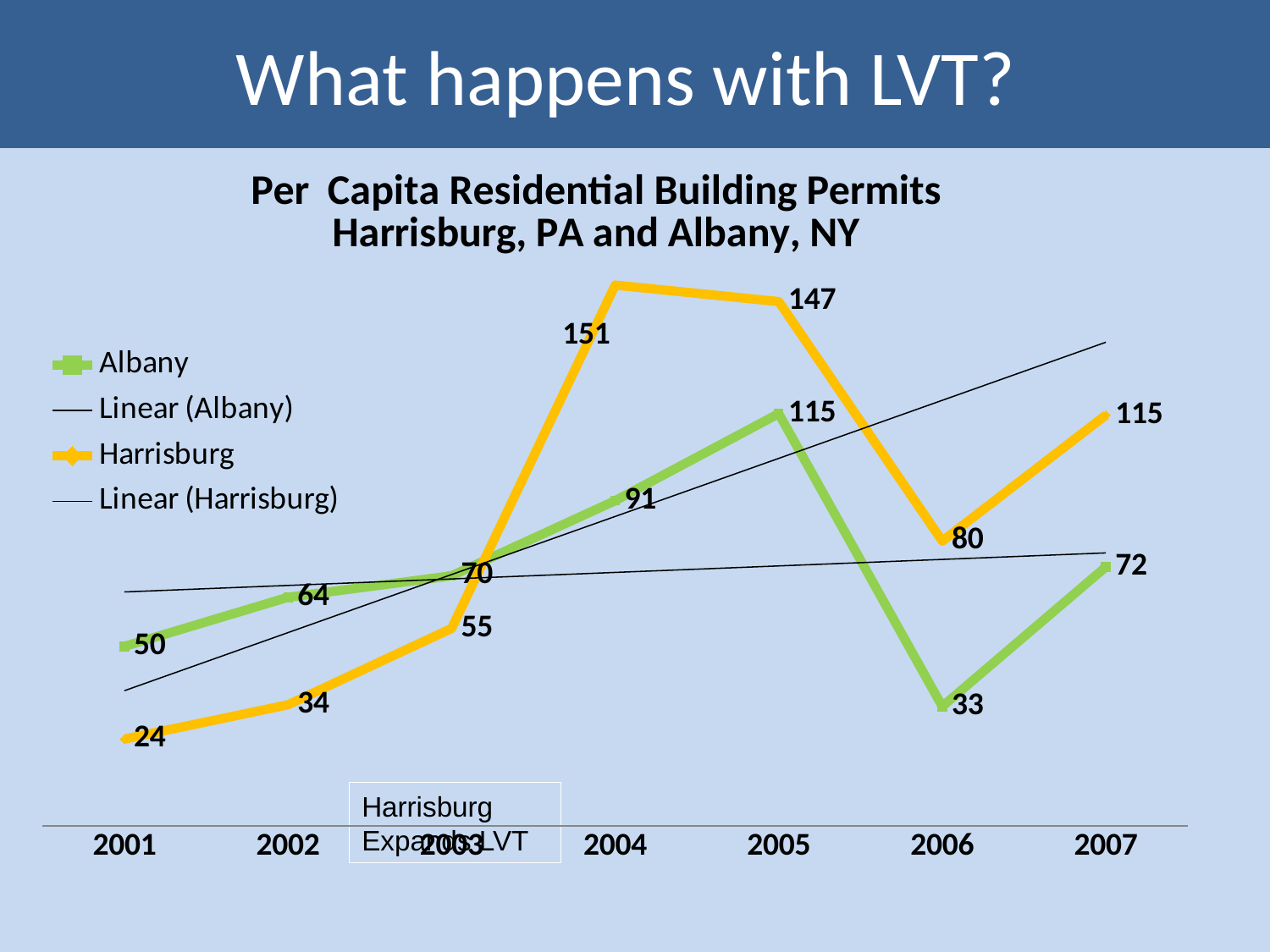
What is the Albany value for 2006? 33 What is the Harrisburg value for 2001? 24 What is the difference between the Harrisburg and Albany values in 2007? 43 Does the Harrisburg series rise or fall from 2001 to 2004? Rise Which series has the larger value in 2002, Albany or Harrisburg? Albany How many entries does the legend list? 4 What is the title of the chart? Per Capita Residential Building Permits Harrisburg, PA and Albany, NY In which year is the Harrisburg value lowest? 2001 How many years are shown on the x axis? 7 What kind of chart is shown on the slide? Line chart In which year does Albany reach its highest value? 2005 What is the Harrisburg value for 2004? 151